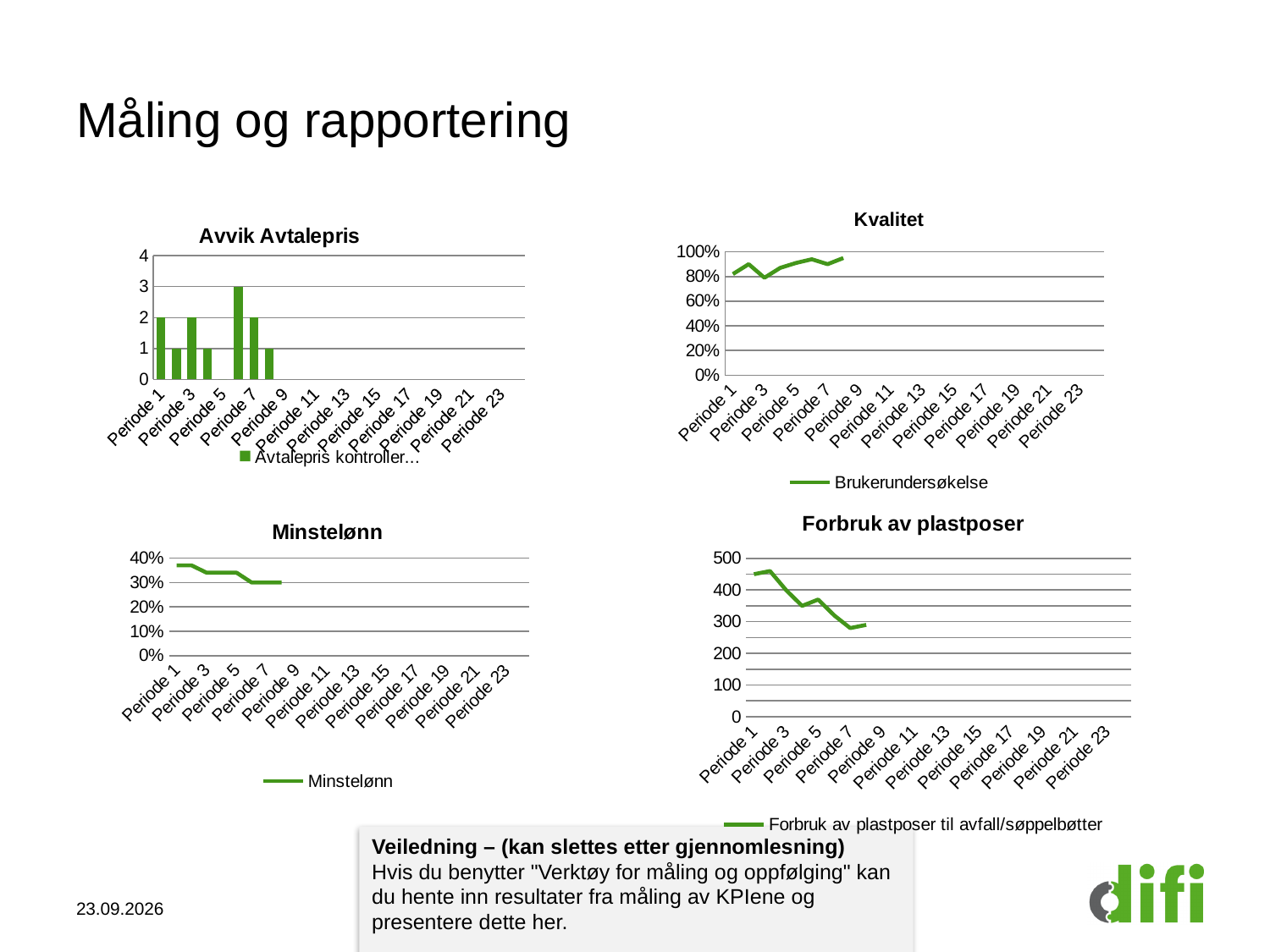
How many series does the legend of the 'Kvalitet' chart list? 1 In the 'Forbruk av plastposer' chart, do the values generally rise or fall from Periode 1 to Periode 8? Fall In the 'Avvik Avtalepris' chart, what is the highest value reached by any bar? 3 In the 'Minstelønn' chart, is the value for Periode 1 greater or less than 30%? greater In the 'Kvalitet' chart, is the value for Periode 1 greater or less than 60%? greater What is the legend entry of the 'Forbruk av plastposer' chart? Forbruk av plastposer til avfall/søppelbøtter In the 'Forbruk av plastposer' chart, is the value for Periode 1 greater or less than 400? greater What kind of chart is 'Avvik Avtalepris'? Bar chart In the 'Avvik Avtalepris' chart, what is the value for Periode 1? 2 In the 'Forbruk av plastposer' chart, which is larger: the value for Periode 1 or the value for Periode 7? Periode 1 What kind of chart is 'Kvalitet'? Line chart In the 'Minstelønn' chart, do the values rise or fall along the x axis? Fall